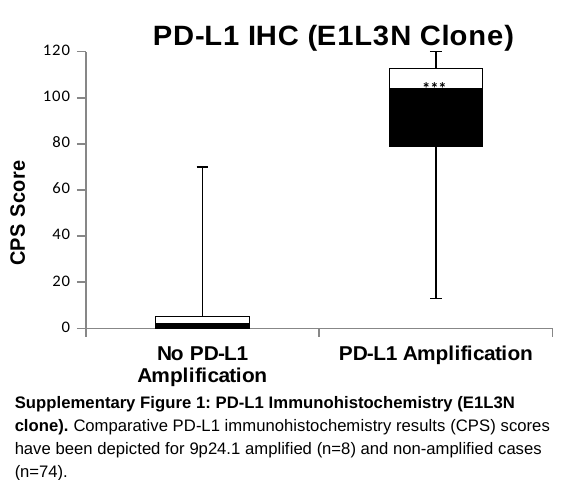
What is the label on the y axis of the chart? CPS Score Is the median CPS Score for No PD-L1 Amplification greater or less than 20? less Is the bottom of the lower whisker for PD-L1 Amplification greater or less than 20? less Is the top of the upper whisker for No PD-L1 Amplification greater or less than 80? less What is the highest value shown on the y axis? 120 Which group has the higher median CPS Score? PD-L1 Amplification How many groups are plotted on the x axis? 2 Which group has the lower median CPS Score? No PD-L1 Amplification What kind of chart is shown on the slide? Box plot What is the title of the chart? PD-L1 IHC (E1L3N Clone)